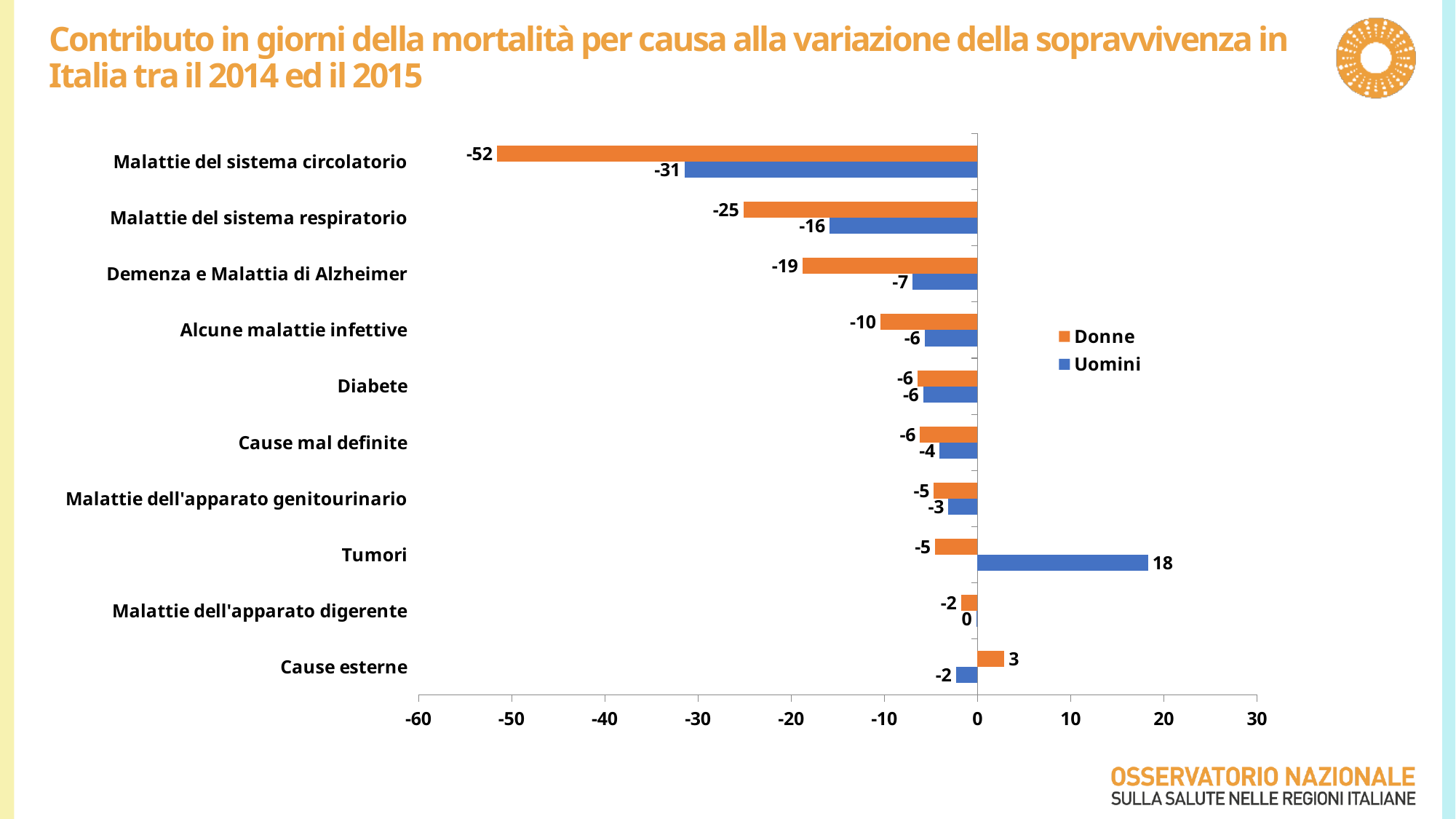
Which category has the lowest value for Donne? Malattie del sistema circolatorio What is the value for Uomini for Malattie del sistema respiratorio? -16 What is the value for Uomini for Tumori? 18 How many categories are shown on the chart? 10 Which is larger, the Donne value for Demenza e Malattia di Alzheimer or the Uomini value for Demenza e Malattia di Alzheimer? Uomini What is the value for Donne for Cause esterne? 3 How many series does the legend list? 2 What kind of chart is shown on the slide? Bar chart What is the difference between the Donne and Uomini values for Malattie del sistema circolatorio? 21 Which category has the highest value for Uomini? Tumori Which colour represents the Uomini series? Blue What is the value for Donne for Malattie del sistema circolatorio? -52